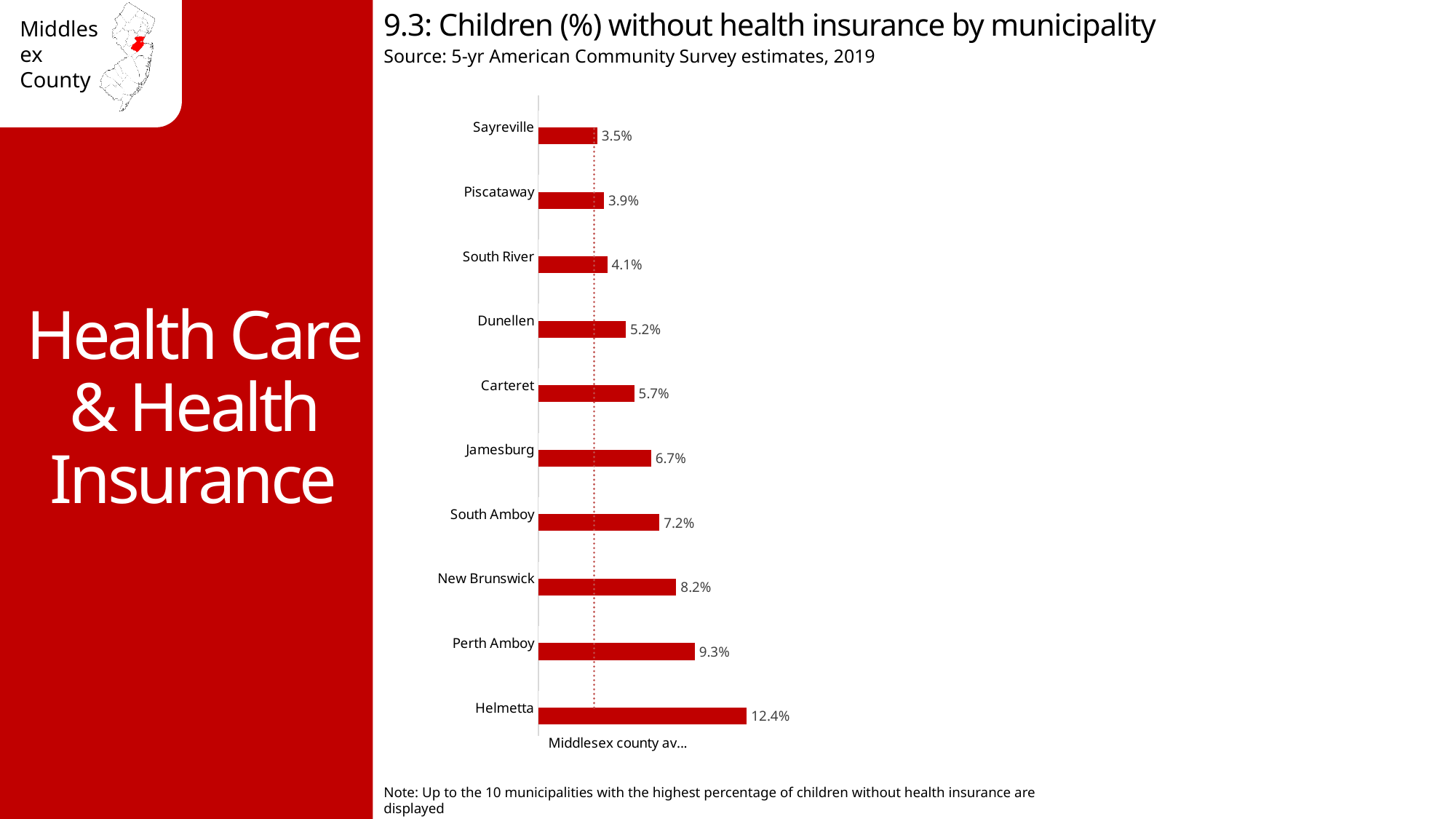
What is the value shown for New Brunswick? 8.2% What kind of chart is shown on the slide? Bar chart What is the difference between the values for Helmetta and Sayreville? 8.9% How many municipalities are shown in the chart? 10 What is the difference between the values for Perth Amboy and South Amboy? 2.1% What is the value shown for Jamesburg? 6.7% What percentage of children are without health insurance in Helmetta? 12.4% What is the value shown for Sayreville? 3.5% Which has a higher value, Carteret or Dunellen? Carteret Which municipality has the lowest percentage of children without health insurance? Sayreville Which municipality has the highest percentage of children without health insurance? Helmetta What does the dotted vertical line in the chart represent? Middlesex county average